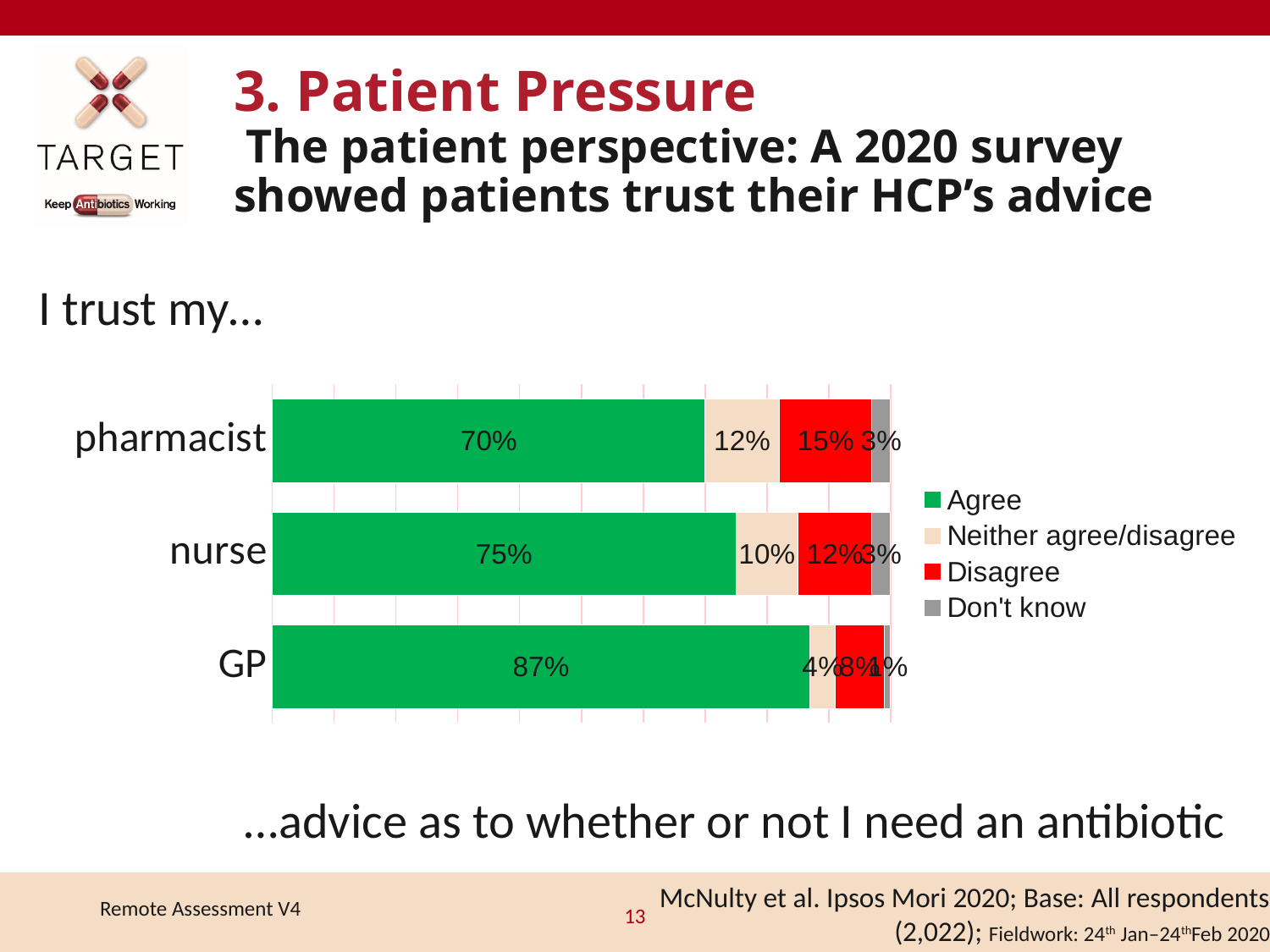
Which has a larger 'Agree' percentage, nurse or pharmacist? nurse What is the 'Neither agree/disagree' value for pharmacist? 12% Which healthcare professional has the highest 'Agree' percentage? GP What is the 'Neither agree/disagree' value for nurse? 10% Which healthcare professional has the lowest 'Agree' percentage? pharmacist How many healthcare professional categories are shown in the chart? 3 How many series does the legend list? 4 What percentage of respondents agree that they trust their nurse's advice? 75% What percentage of respondents agree that they trust their GP's advice? 87% What percentage of respondents agree that they trust their pharmacist's advice? 70% What is the difference between the 'Agree' percentages for GP and pharmacist? 17% What is the 'Disagree' value for pharmacist? 15%